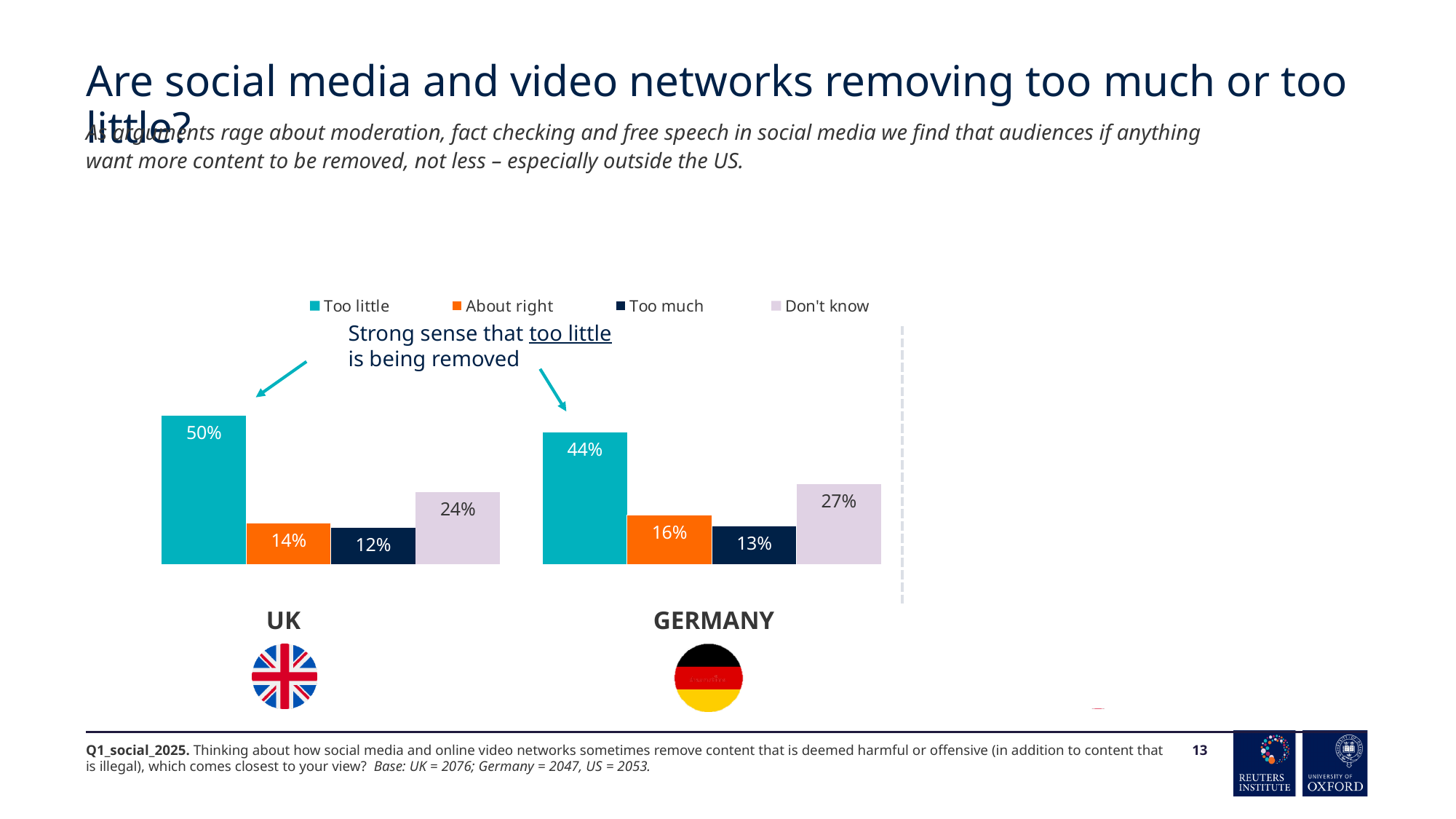
Which country has the larger 'Don't know' share, the UK or Germany? Germany What is the difference between the 'Too little' values for the UK and Germany? 6 percentage points What percentage of UK respondents say social media networks remove too little content? 50% What is the 'About right' value for the UK? 14% How many series does the legend list? 4 Which response category has the lowest value for Germany? Too much What type of chart is shown on the slide? Bar chart Which response category has the highest value for the UK? Too little What percentage of Germany respondents say social media networks remove too little content? 44% How many countries are shown in the chart? 2 What is the 'Too much' value for Germany? 13% What is the 'Don't know' value for Germany? 27%